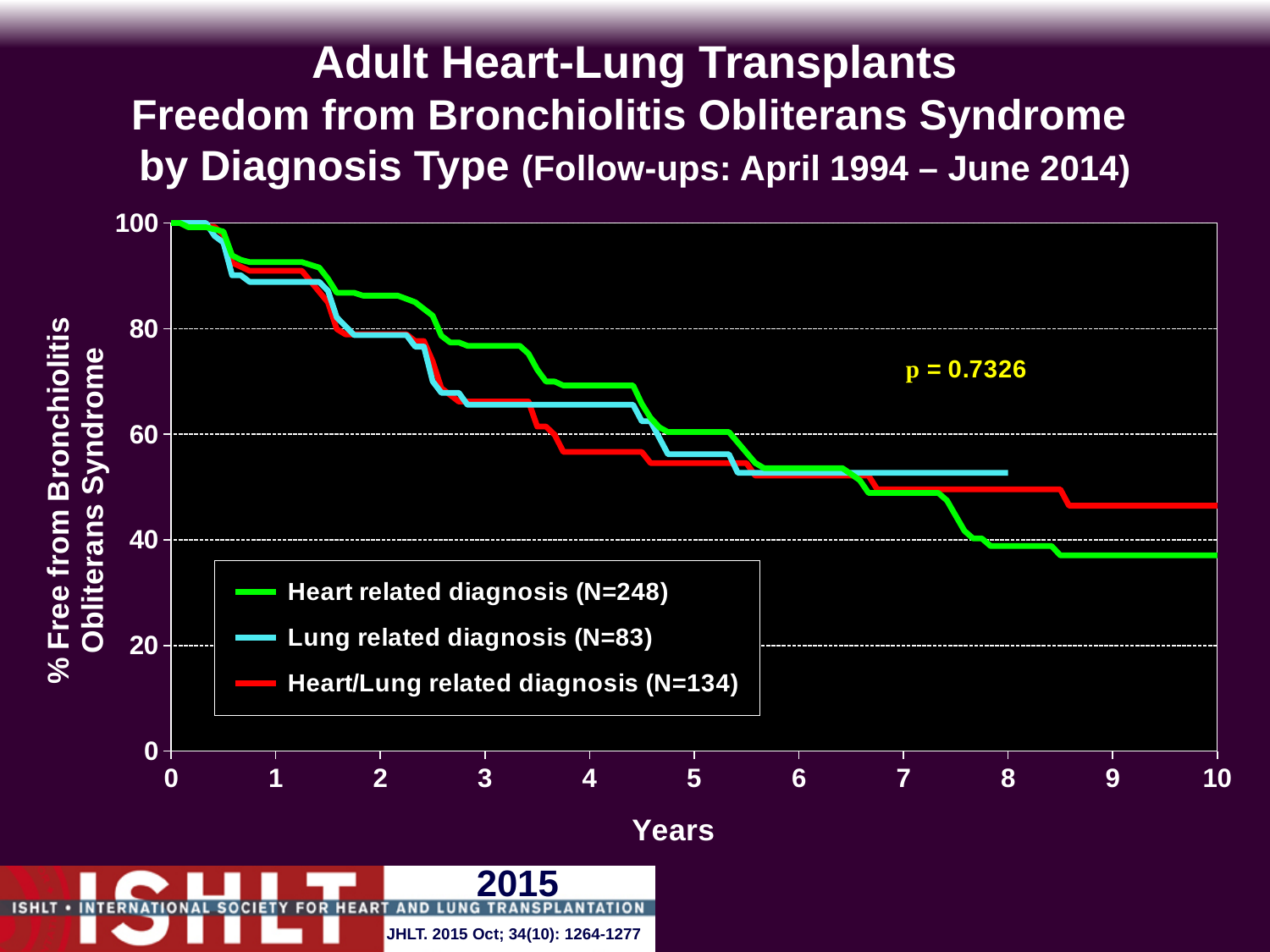
At 4 years, which series has the higher value: Lung related diagnosis or Heart/Lung related diagnosis? Lung related diagnosis Is the value for the Heart/Lung related diagnosis series at 10 years greater or less than 40? greater At 10 years, which series has the higher value: Heart related diagnosis or Heart/Lung related diagnosis? Heart/Lung related diagnosis Is the value for the Heart related diagnosis series at 3 years greater or less than 60? greater Is the value for the Heart/Lung related diagnosis series at 4 years greater or less than 60? less Do the values for the Heart related diagnosis series rise or fall as the years increase? fall How many series does the legend list? 3 What is the sample size (N) given in the legend for the Lung related diagnosis series? 83 What kind of chart is shown on the slide? line chart What is the p-value shown on the chart? p = 0.7326